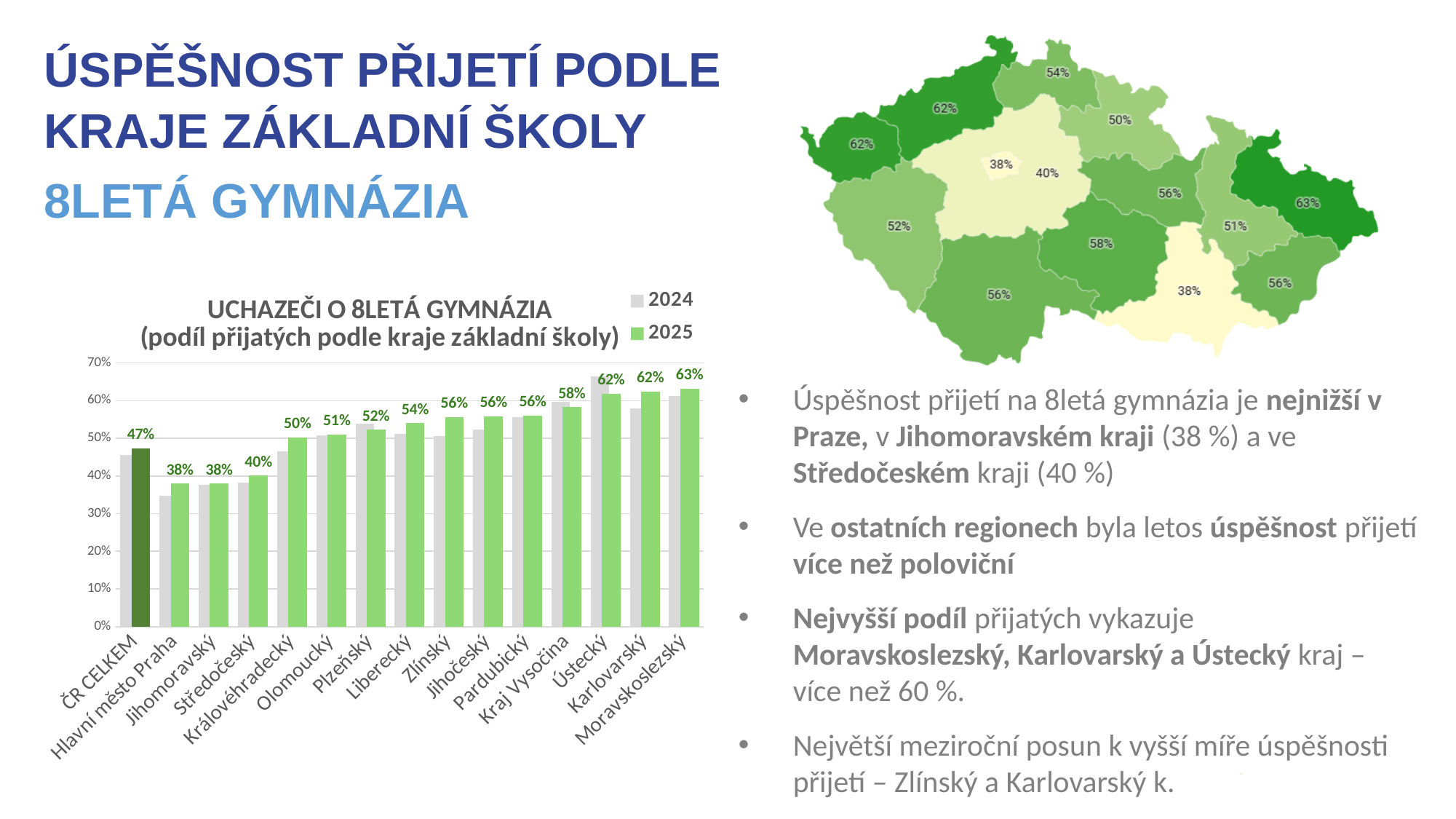
Is the 2024 value for Ústecký greater or less than 60%? greater Which has the larger 2025 value in the bar chart, Kraj Vysočina or Liberecký? Kraj Vysočina Do the 2025 values generally rise or fall from Hlavní město Praha to Moravskoslezský along the x axis? rise What is the 2025 value for Kraj Vysočina in the bar chart? 58% What is the difference between the 2025 values for Moravskoslezský and Hlavní město Praha? 25 percentage points Which category has the highest 2025 value in the bar chart? Moravskoslezský What is the 2025 value for Moravskoslezský in the bar chart? 63% What kind of chart is shown on the left of the slide? bar chart Is the 2024 value for Hlavní město Praha greater or less than 40%? less How many categories are shown on the x axis of the bar chart? 15 How many series does the legend of the bar chart list? 2 What is the 2025 value for ČR CELKEM in the bar chart? 47%